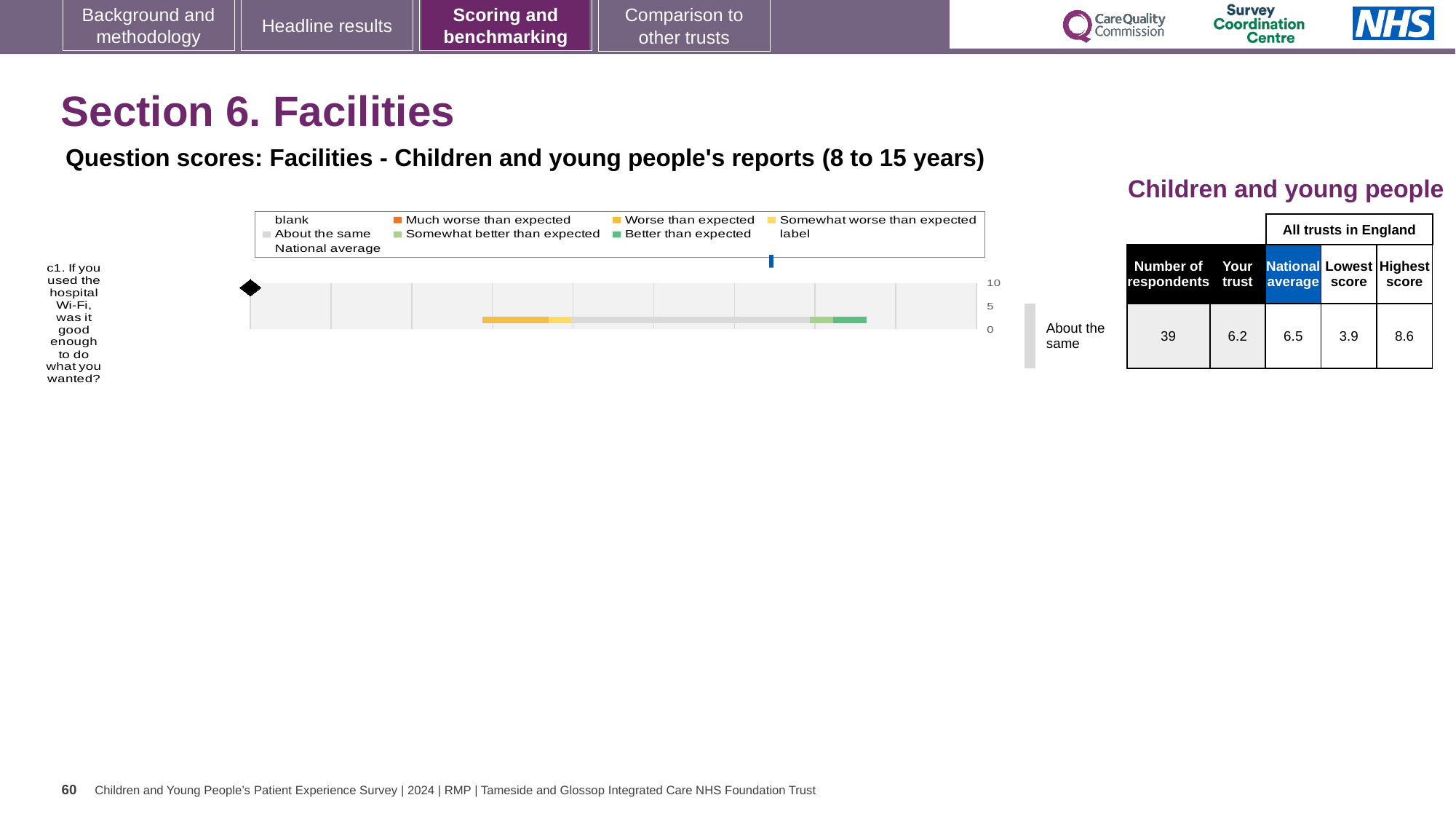
What kind of chart is used to show the question score for c1 about hospital Wi-Fi? bar chart What is the lowest score among all trusts in England for question c1? 3.9 By how much does the national average exceed the trust's score for question c1? 0.3 What colour represents 'Better than expected' in the chart legend? Green How many respondents answered question c1 about hospital Wi-Fi? 39 Which is larger for question c1: the trust's score or the national average? National average How many survey questions are plotted in the Facilities chart? 1 What is the 'Your trust' score for question c1 (hospital Wi-Fi)? 6.2 Which benchmark category is the trust's score for question c1 placed in? About the same What is the difference between the highest score and the lowest score for question c1? 4.7 What is the highest score among all trusts in England for question c1? 8.6 What is the national average score for question c1 (hospital Wi-Fi)? 6.5